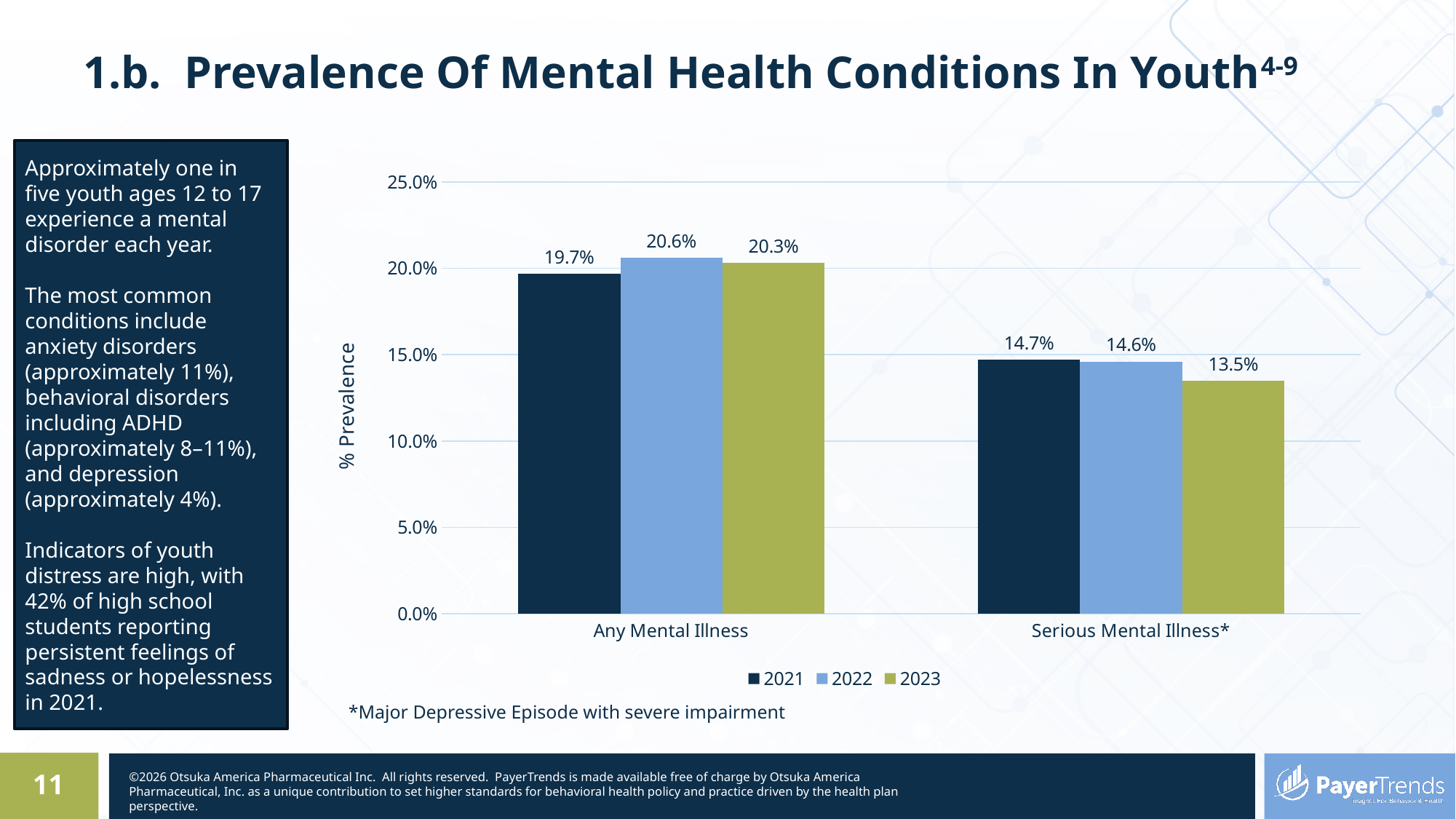
How many series does the legend list? 3 Which is larger: the 2023 value for Any Mental Illness or the 2023 value for Serious Mental Illness*? Any Mental Illness How many categories are shown on the x axis? 2 What is the prevalence of Serious Mental Illness* in 2023? 13.5% What is the prevalence of Any Mental Illness in 2021? 19.7% What is the difference between the 2022 and 2021 values for Any Mental Illness? 0.9% What is the difference between the 2021 and 2023 values for Serious Mental Illness*? 1.2% What kind of chart is shown on the slide? Bar chart Which year has the lowest prevalence for Serious Mental Illness*? 2023 What is the prevalence of Any Mental Illness in 2022? 20.6% What is the label of the y axis? % Prevalence Which year has the highest prevalence for Any Mental Illness? 2022